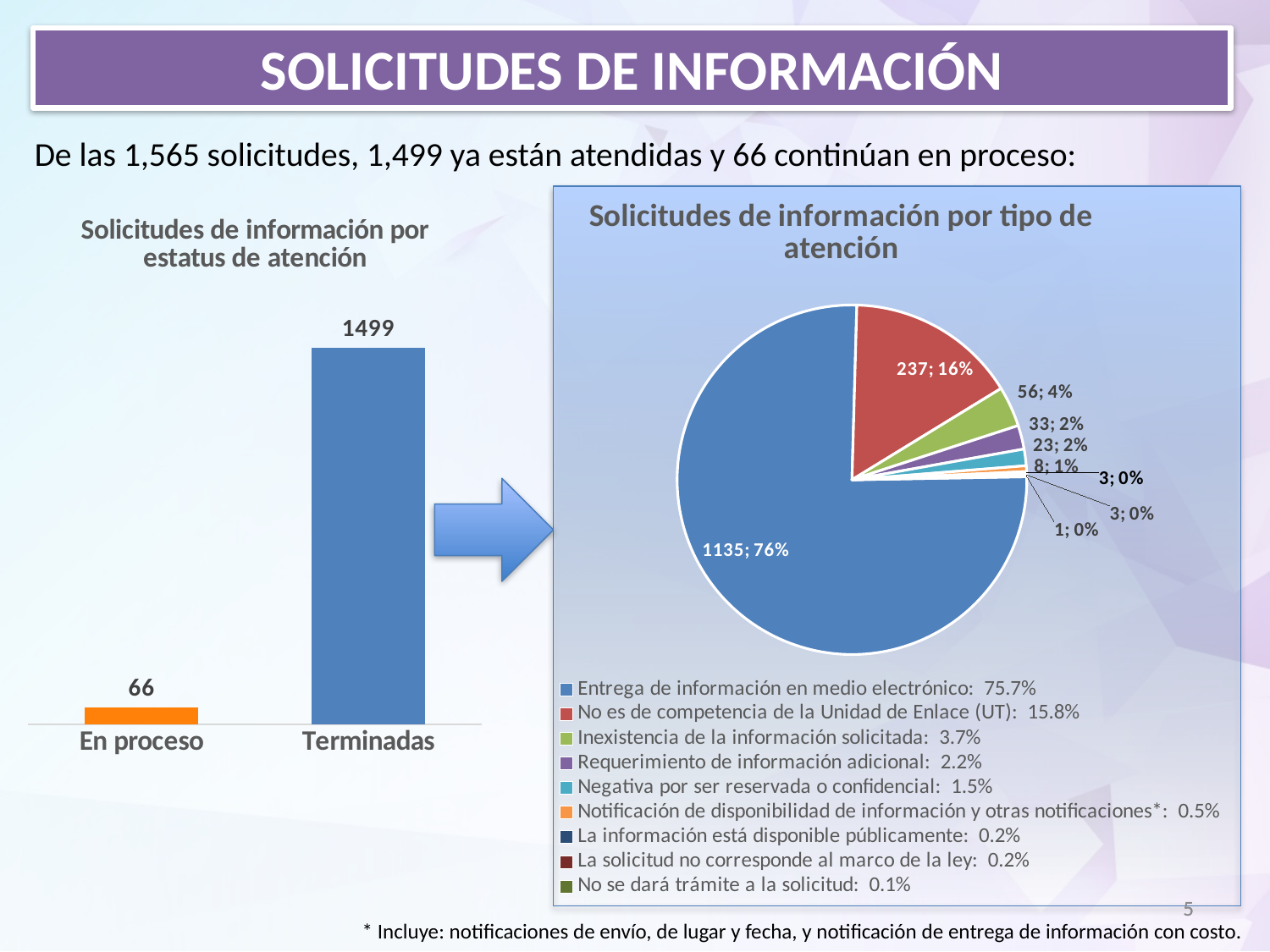
In the chart 'Solicitudes de información por estatus de atención', which category has the higher value? Terminadas How many entries does the legend of the pie chart 'Solicitudes de información por tipo de atención' list? 9 In the pie chart 'Solicitudes de información por tipo de atención', what share does 'No es de competencia de la Unidad de Enlace (UT)' have according to the legend? 15.8% What kind of chart is 'Solicitudes de información por tipo de atención'? Pie chart In the pie chart 'Solicitudes de información por tipo de atención', what is the count shown for the slice labelled 4%? 56 What kind of chart is 'Solicitudes de información por estatus de atención'? Bar chart In the pie chart 'Solicitudes de información por tipo de atención', which category has the smallest share according to the legend? No se dará trámite a la solicitud In the chart 'Solicitudes de información por estatus de atención', what is the difference between Terminadas and En proceso? 1433 In the chart 'Solicitudes de información por estatus de atención', what is the value for Terminadas? 1499 In the pie chart 'Solicitudes de información por tipo de atención', what is the value shown for the largest slice? 1135; 76% In the chart 'Solicitudes de información por estatus de atención', what is the value for En proceso? 66 How many categories are shown in the chart 'Solicitudes de información por estatus de atención'? 2